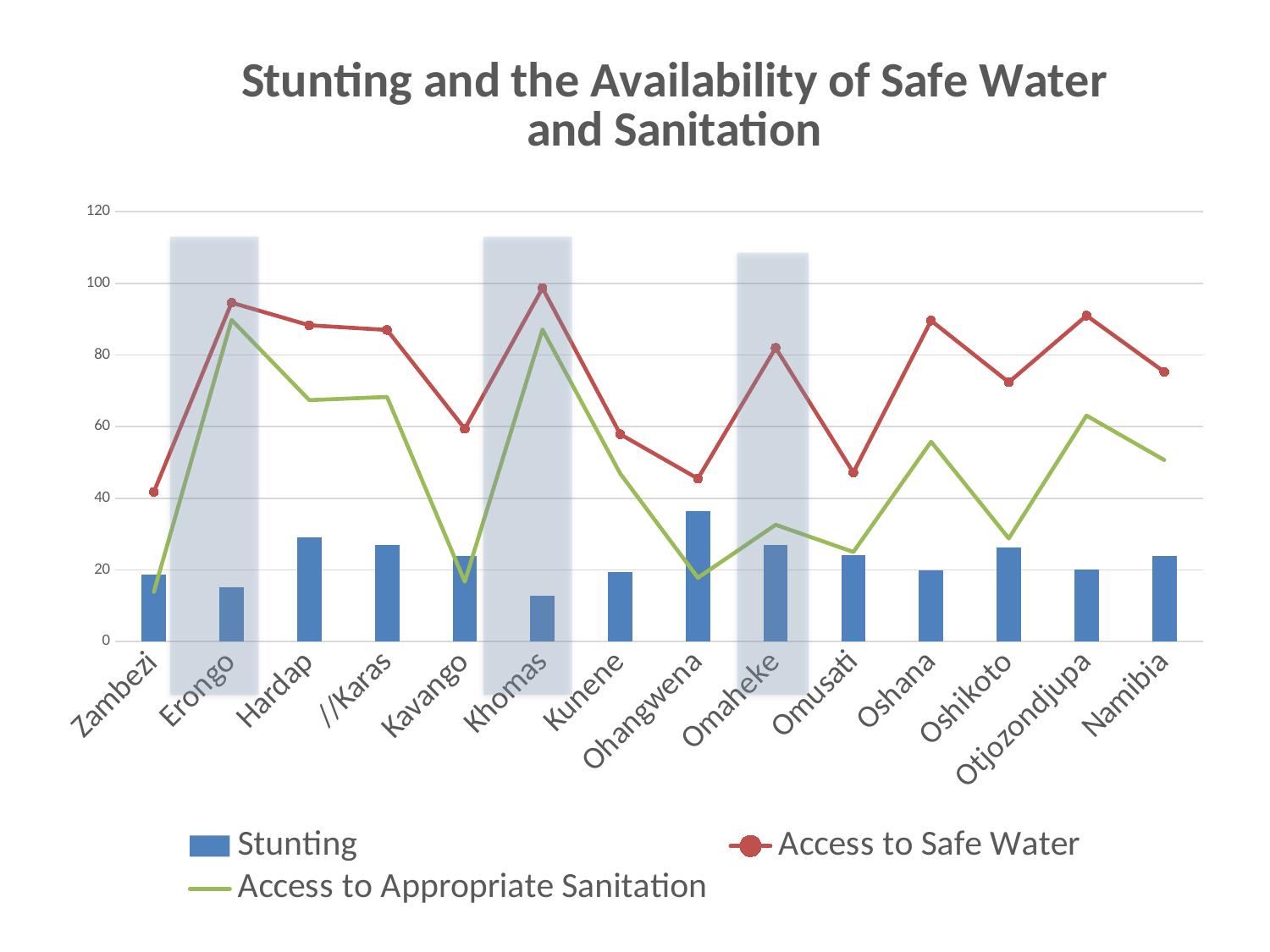
Which has the larger Stunting value, Hardap or Erongo? Hardap How many series does the legend list? 3 Which category has the lowest Access to Safe Water value? Zambezi Is the Access to Safe Water value for Zambezi greater or less than 60? less Which category has the highest Access to Appropriate Sanitation value? Erongo Which category has the highest Access to Safe Water value? Khomas How many categories are shown on the x axis? 14 What is the title of the chart? Stunting and the Availability of Safe Water and Sanitation Which category has the lowest Stunting value? Khomas Which series is plotted as bars? Stunting Which category has the highest Stunting value? Ohangwena What kind of chart is this? Combined bar and line chart